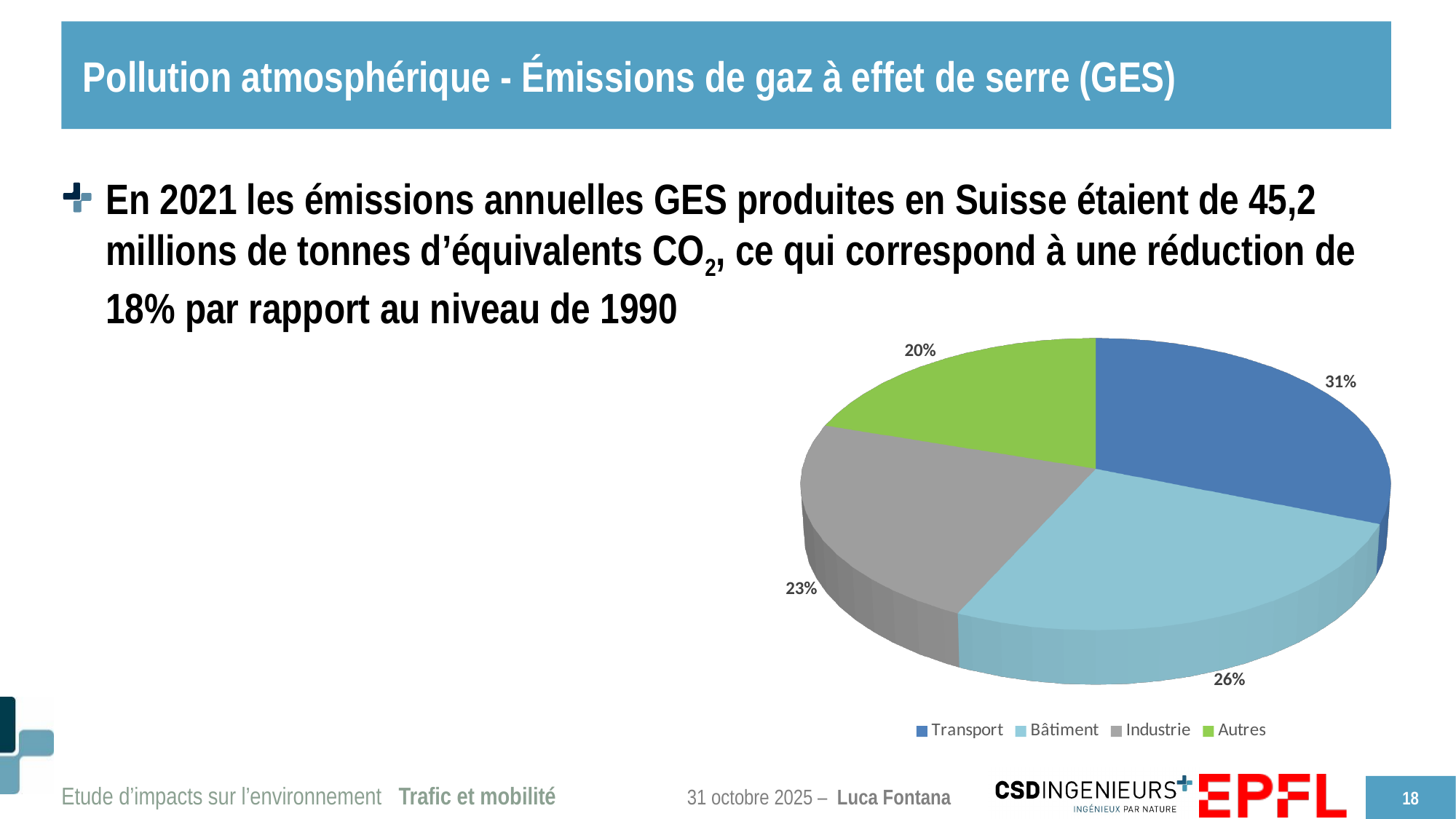
Which is larger, the share for Bâtiment or the share for Industrie? Bâtiment Which colour represents Industrie in the pie chart? Grey Which category has the smallest slice of the pie? Autres What is the difference in percentage points between Transport and Autres? 11 What is the difference in percentage points between Bâtiment and Industrie? 3 What share of the pie does Bâtiment represent? 26% What share of the pie does Autres represent? 20% What kind of chart is shown on the slide? Pie chart Which category has the largest slice of the pie? Transport What share of the pie does Transport represent? 31% How many slices does the pie chart have? 4 What share of the pie does Industrie represent? 23%